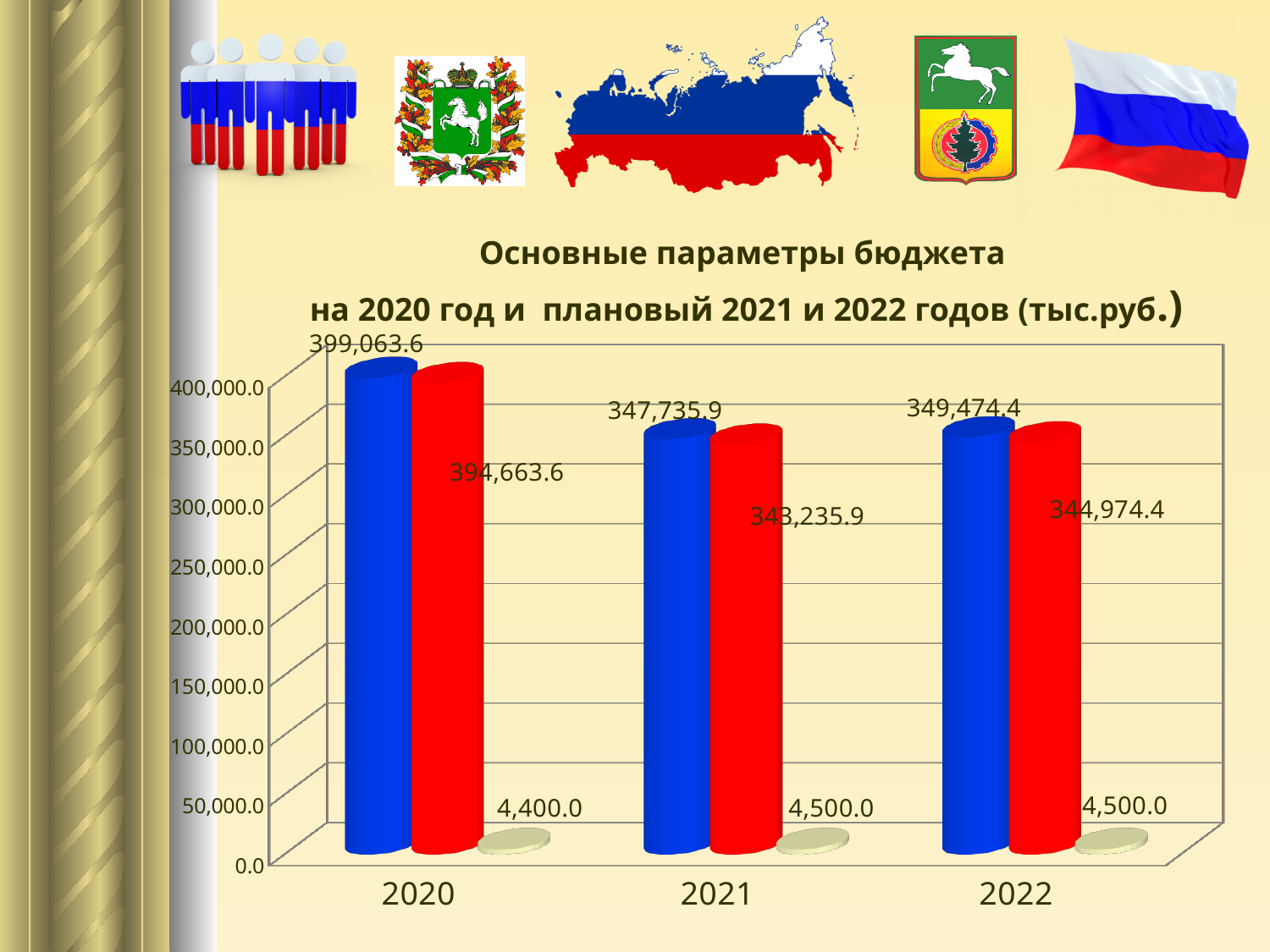
Which year has the larger red bar, 2021 or 2022? 2022 What is the value of the blue bar for 2020? 399,063.6 What is the value of the small pale bar for 2022? 4,500.0 Does the blue bar rise or fall from 2020 to 2021? fall What is the difference between the blue bar and the red bar for 2020? 4,400.0 In which year is the blue bar lowest? 2021 In which year is the blue bar highest? 2020 Is the value of the blue bar for 2021 greater or less than 350,000.0? less What kind of chart is shown on the slide? bar chart How many years are shown on the x axis? 3 By how much does the blue bar for 2020 exceed the blue bar for 2021? 51,327.7 What is the value of the red bar for 2021? 343,235.9